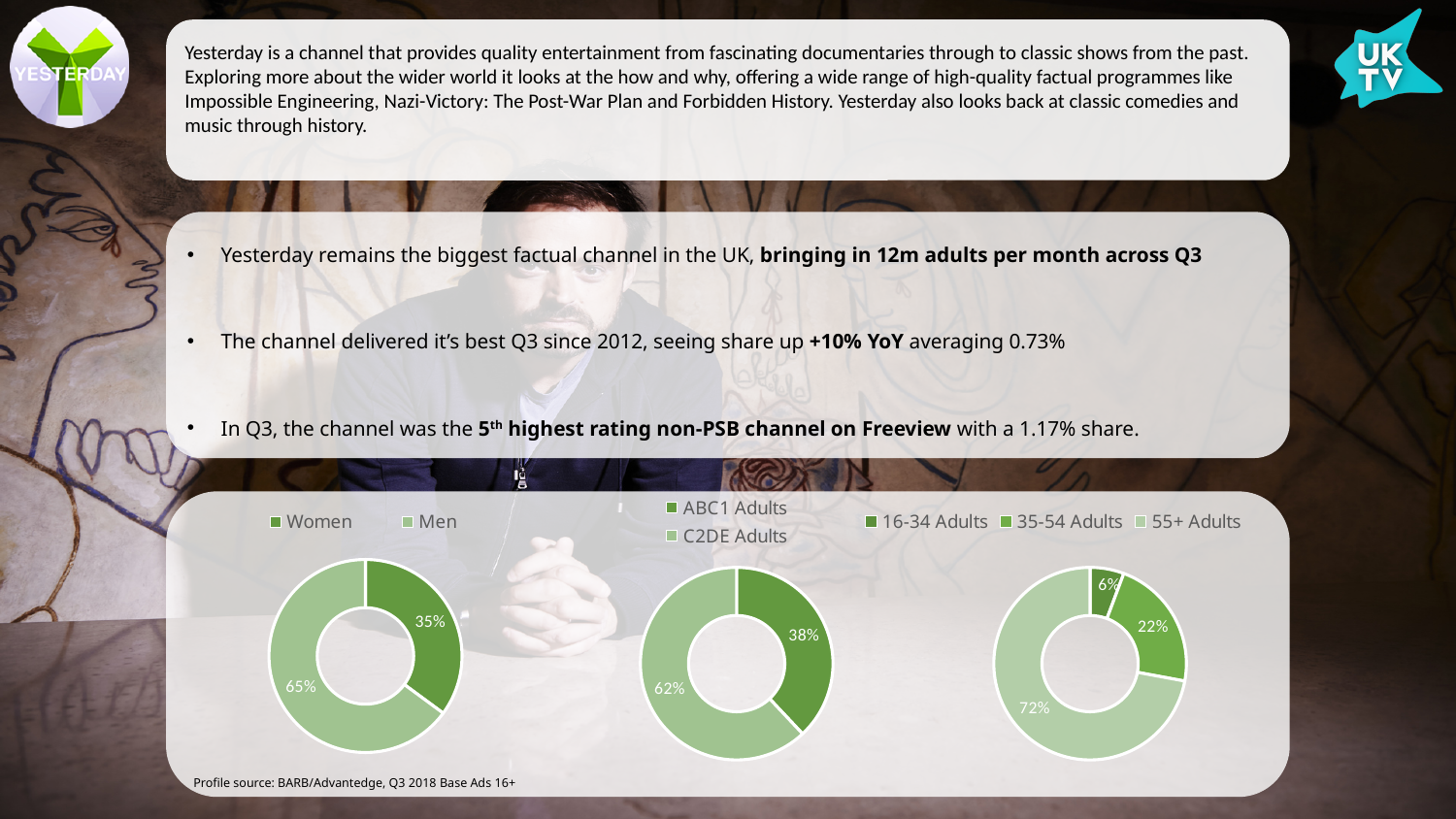
In the left doughnut chart, what share is Women? 35% In the right doughnut chart, what share is 16-34 Adults? 6% In the right doughnut chart, what share is 35-54 Adults? 22% In the left doughnut chart, which group has the larger share, Women or Men? Men In the middle doughnut chart, what share is C2DE Adults? 62% In the right doughnut chart, which age group has the smallest share? 16-34 Adults In the middle doughnut chart, what is the difference between the C2DE Adults share and the ABC1 Adults share? 24% In the right doughnut chart, which age group has the largest share? 55+ Adults How many categories does the legend of the right doughnut chart list? 3 In the middle doughnut chart, what share is ABC1 Adults? 38% What kind of chart is used for the three charts at the bottom of the slide? Doughnut chart In the left doughnut chart, what share is Men? 65%